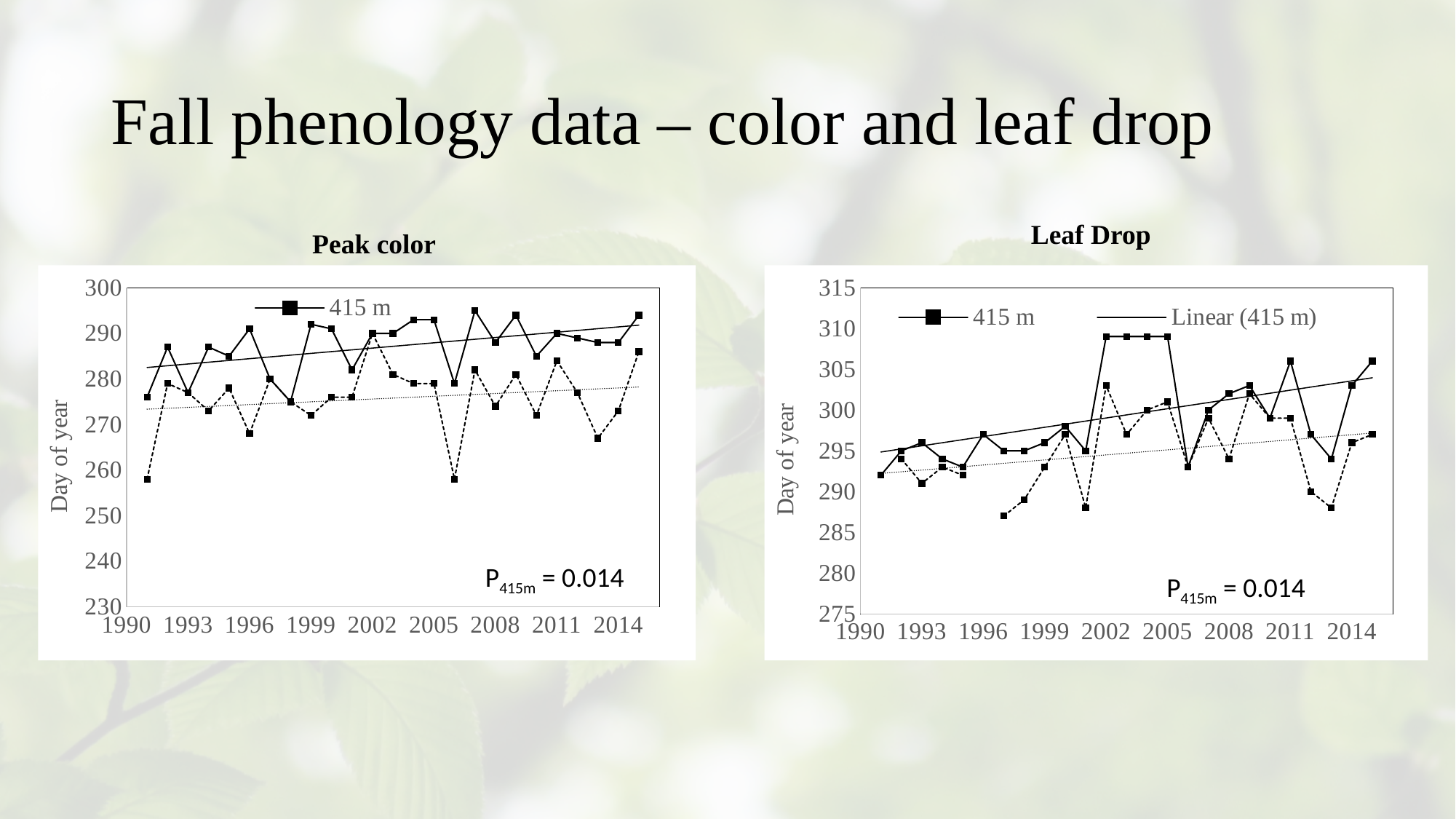
In the Leaf Drop chart, is the value of the solid 415 m line in 2006 greater or less than 295? less What P value is printed on the Leaf Drop chart? P415m = 0.014 How many entries does the legend of the Leaf Drop chart list? 2 In the Peak color chart, is the value of the solid 415 m line in 2007 greater or less than 290? greater What kind of chart is the Peak color chart? line chart In the Peak color chart, is the value of the dashed line in 2006 greater or less than 260? less What is the y-axis label on the Peak color chart? Day of year In the Leaf Drop chart, does the Linear (415 m) trend line rise or fall from 1990 to 2014? rise How many entries does the legend of the Peak color chart list? 1